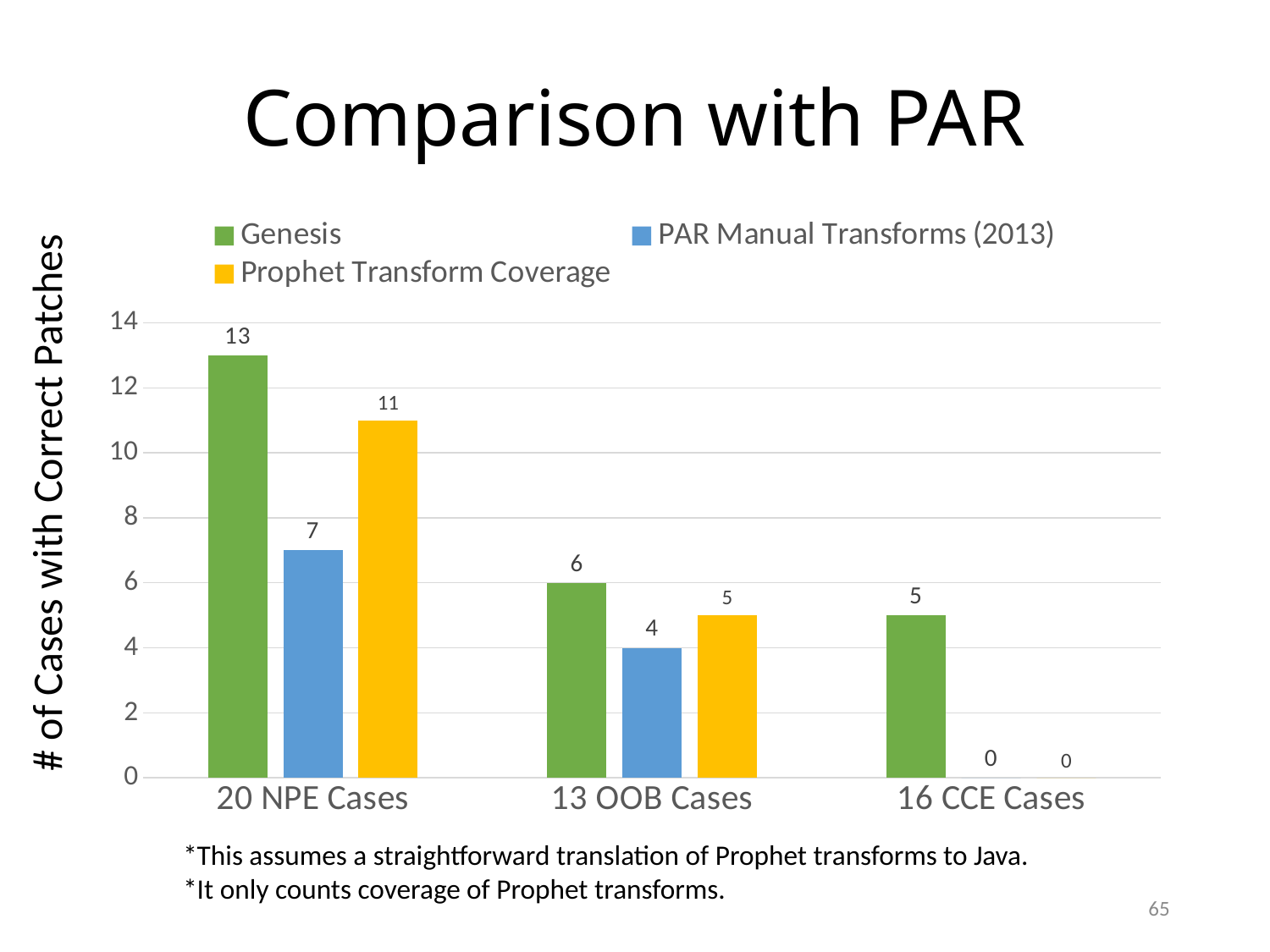
In the 13 OOB Cases category, which is larger: Genesis or Prophet Transform Coverage? Genesis What is the value for Prophet Transform Coverage in the 20 NPE Cases category? 11 What is the difference between the Genesis and PAR Manual Transforms (2013) values in the 20 NPE Cases category? 6 What is the value for PAR Manual Transforms (2013) in the 13 OOB Cases category? 4 Which category has the lowest value for Prophet Transform Coverage? 16 CCE Cases How many series does the legend list? 3 What is the value for Genesis in the 20 NPE Cases category? 13 What is the value for PAR Manual Transforms (2013) in the 16 CCE Cases category? 0 Which category has the highest value for Genesis? 20 NPE Cases What is the title of the slide? Comparison with PAR What kind of chart is shown on the slide? Bar chart How many categories are shown on the x axis? 3